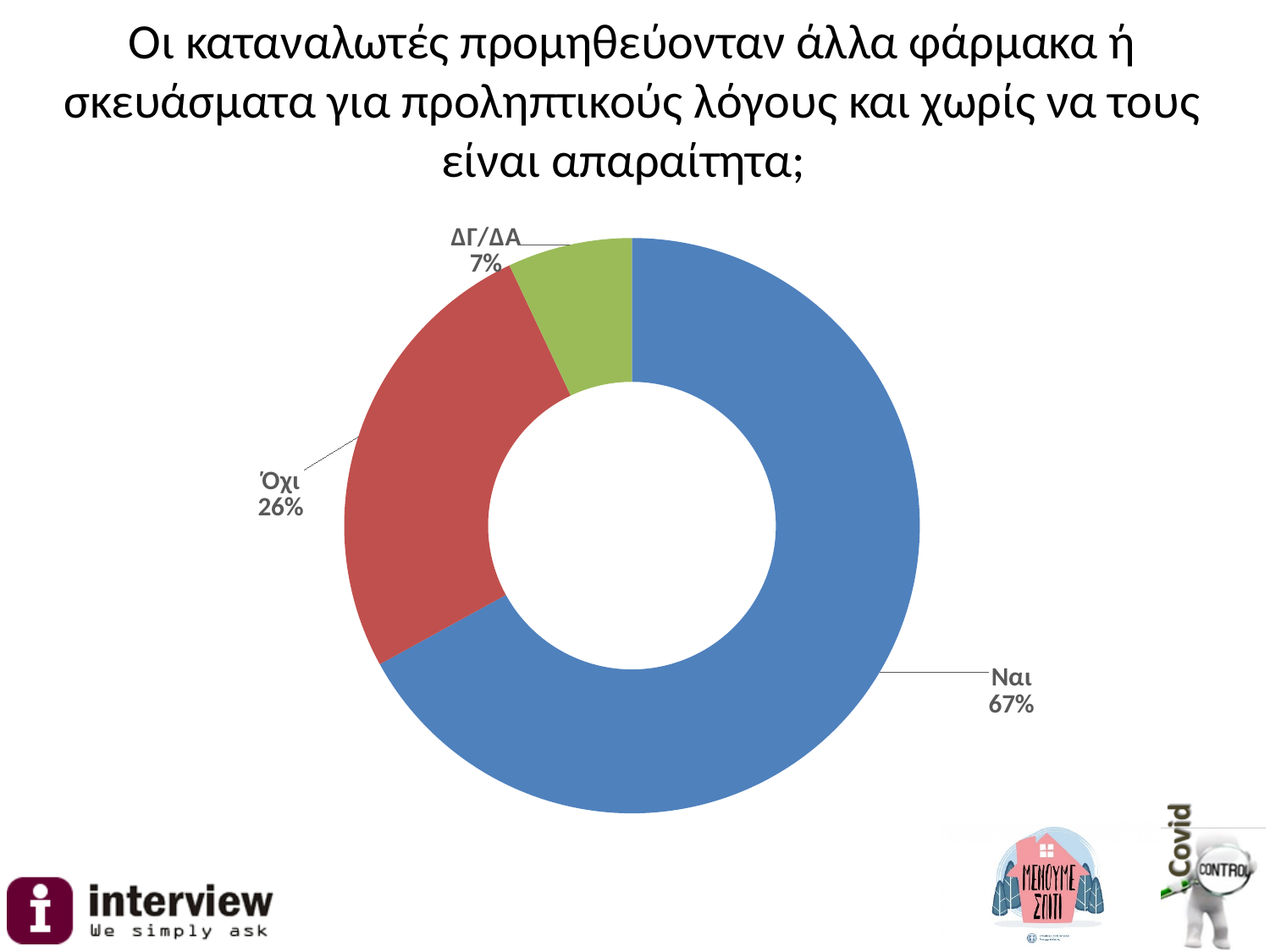
What kind of chart is shown on the slide? Pie chart (doughnut) What colour is the slice for Όχι? Red How many response categories are shown in the chart? 3 Which is larger, the share for Όχι or the share for ΔΓ/ΔΑ? Όχι Which response has the smallest share of the chart? ΔΓ/ΔΑ Which response has the largest share of the chart? Ναι What is the difference in percentage points between Ναι and Όχι? 41 What percentage of respondents answered Όχι? 26% What is the difference in percentage points between Όχι and ΔΓ/ΔΑ? 19 What percentage of respondents answered ΔΓ/ΔΑ? 7% What percentage of respondents answered Ναι? 67% What colour is the slice for Ναι? Blue